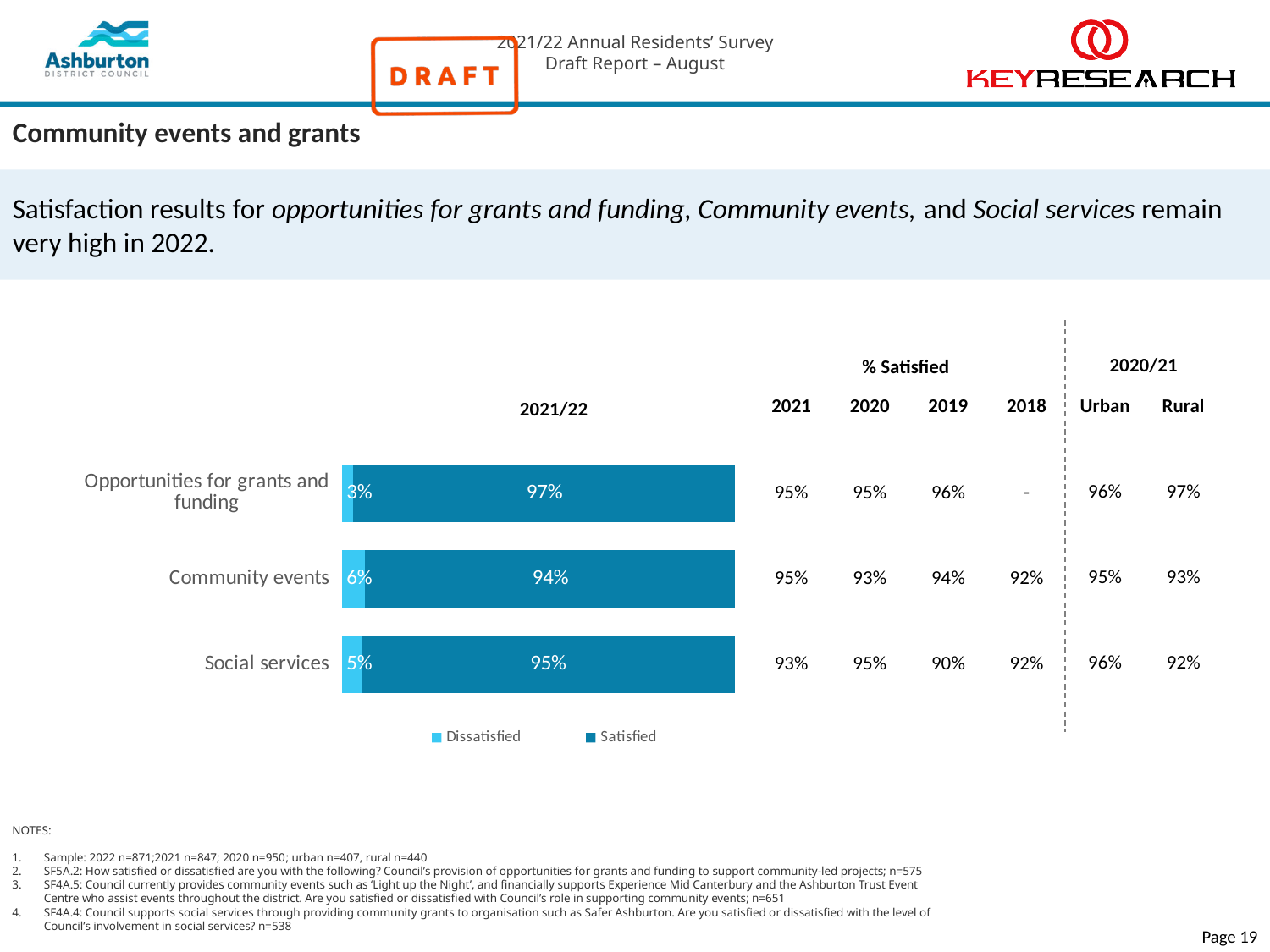
How many series does the legend list? 2 How many categories are shown in the bar chart? 3 What is the total of the Dissatisfied and Satisfied segments for Social services in 2021/22? 100% Which has a larger Dissatisfied percentage in 2021/22, Community events or Social services? Community events What percentage of respondents were satisfied with Opportunities for grants and funding in 2021/22? 97% Which category has the lowest Satisfied percentage in 2021/22? Community events What is the Satisfied value for Social services in 2021/22? 95% What kind of chart is shown on the slide? Stacked bar chart What are the two legend entries of the chart? Dissatisfied and Satisfied What percentage of respondents were dissatisfied with Community events in 2021/22? 6% Which category has the highest Satisfied percentage in 2021/22? Opportunities for grants and funding What is the difference between the Satisfied percentages for Opportunities for grants and funding and Community events in 2021/22? 3%